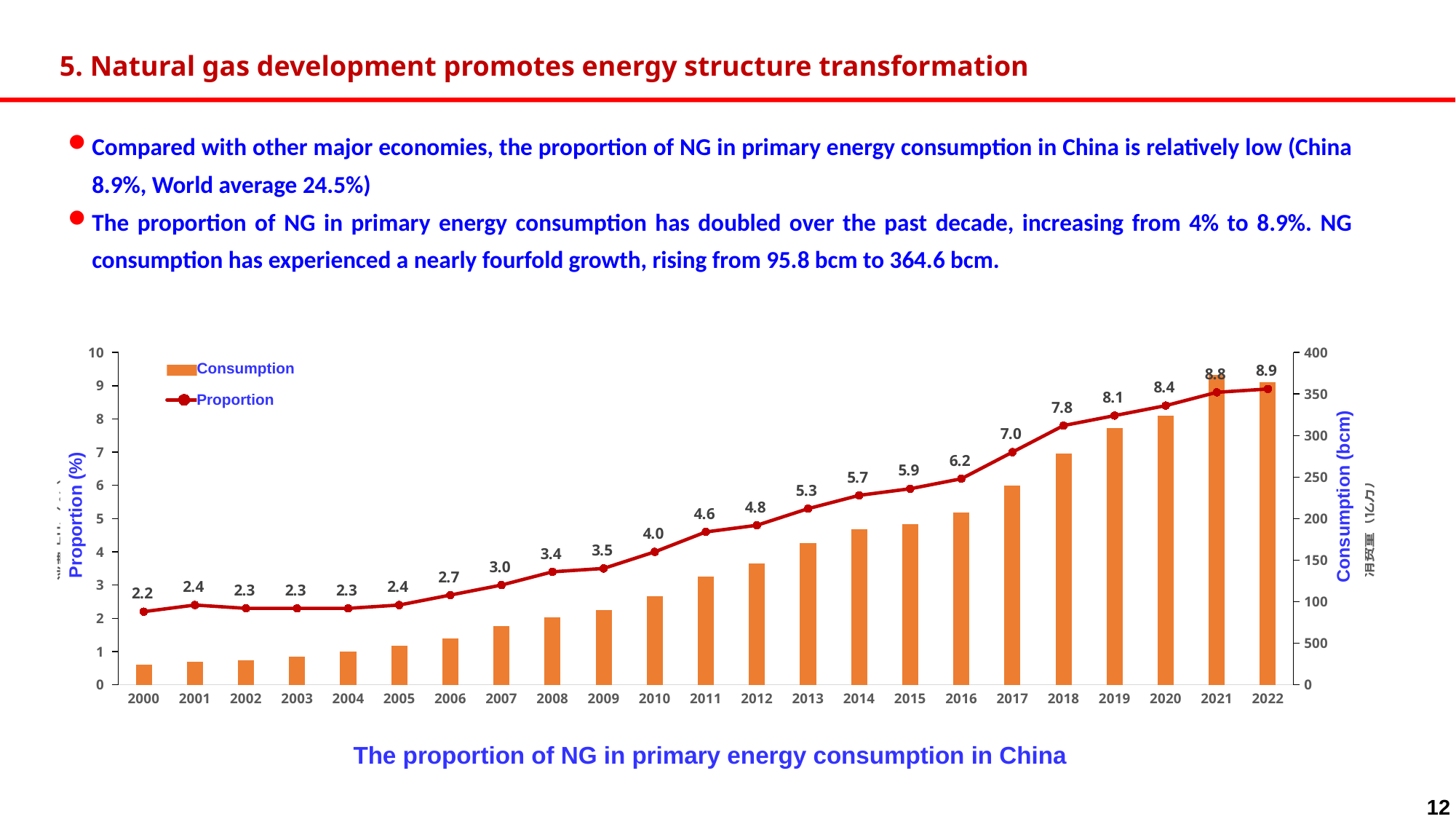
How many years are shown on the x axis? 23 What is the Proportion value for 2022? 8.9 Is the Consumption value for 2000 greater or less than 50? less What is the Proportion value for 2010? 4.0 Which year has the highest Proportion value? 2022 Does the Proportion line generally rise or fall from 2000 to 2022? rise What is the difference between the Proportion values for 2022 and 2012? 4.1 How many series does the legend list? 2 What is the Proportion value for 2000? 2.2 Which is larger, the Proportion value for 2017 or for 2013? 2017 Which year has the lowest Proportion value? 2000 Is the Consumption value for 2022 greater or less than 350? greater